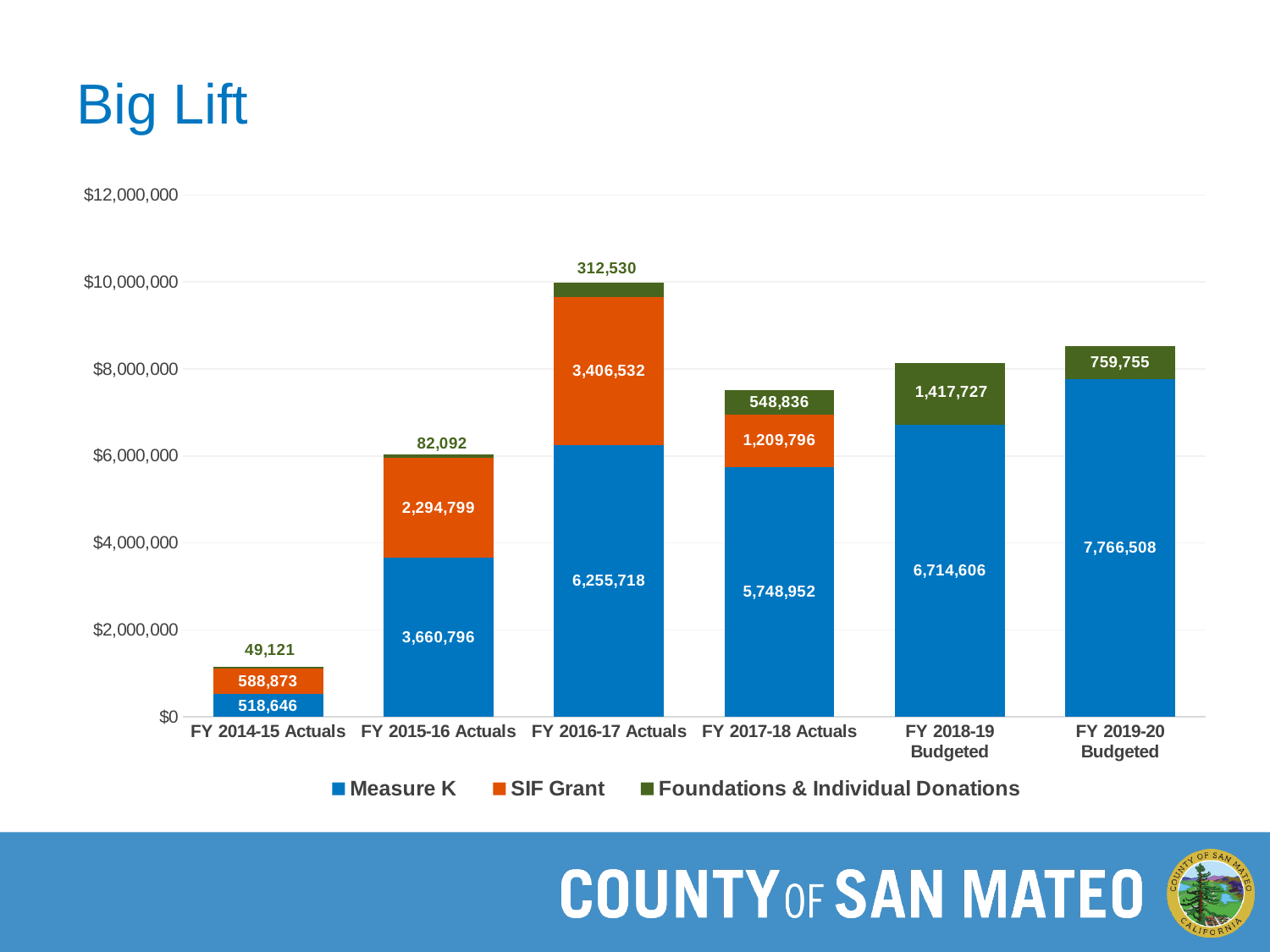
What is the total of the stacked bar for FY 2018-19 Budgeted? 8,132,333 What is the total of the stacked bar for FY 2014-15 Actuals? 1,156,640 What is the Foundations & Individual Donations value for FY 2018-19 Budgeted? 1,417,727 What is the SIF Grant value for FY 2015-16 Actuals? 2,294,799 Which fiscal year has the lowest Foundations & Individual Donations value? FY 2014-15 Actuals What kind of chart is shown on the slide? Stacked bar chart What is the Measure K value for FY 2016-17 Actuals? 6,255,718 Which fiscal year has the highest Measure K value? FY 2019-20 Budgeted What is the difference between the Measure K values for FY 2019-20 Budgeted and FY 2018-19 Budgeted? 1,051,902 How many fiscal year categories are shown on the x axis? 6 Which is larger, the SIF Grant value for FY 2016-17 Actuals or for FY 2017-18 Actuals? FY 2016-17 Actuals How many series does the legend list? 3